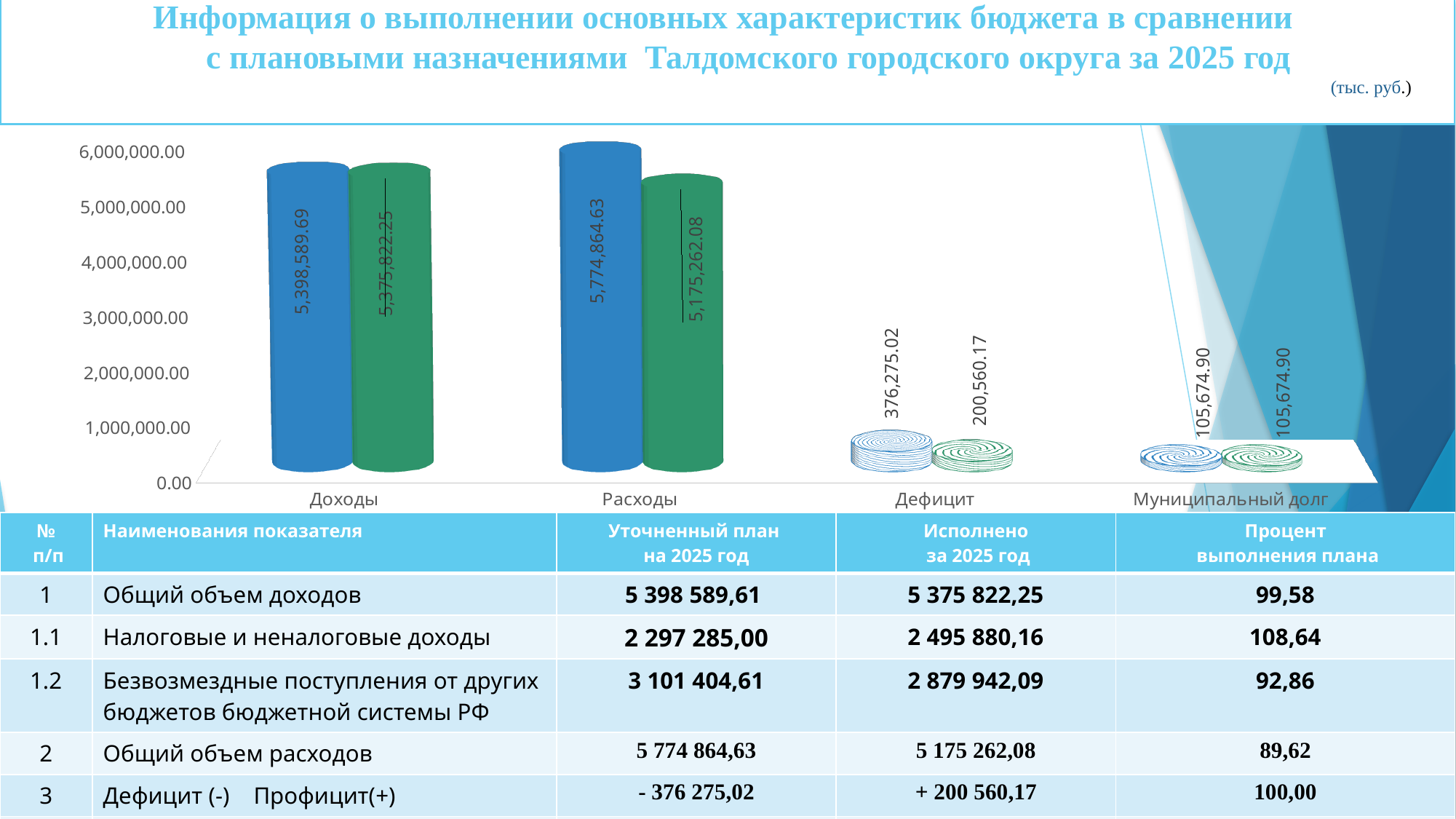
Which category has the lowest green bar? Муниципальный долг For Доходы, which bar is larger, the blue one or the green one? blue Which category has the highest blue bar? Расходы What is the value shown on the blue bar for Дефицит? 376,275.02 What is the difference between the blue and green bars for Дефицит? 175,714.85 Is the value of the blue bar for Дефицит greater or less than 1,000,000.00? less What kind of chart is shown on the slide? bar chart What is the value shown on the green bar for Расходы? 5,175,262.08 What is the difference between the blue and green bars for Расходы? 599,602.55 What is the value shown on the blue bar for Доходы? 5,398,589.69 How many categories are shown on the x axis of the chart? 4 What is the value shown on the green bar for Муниципальный долг? 105,674.90